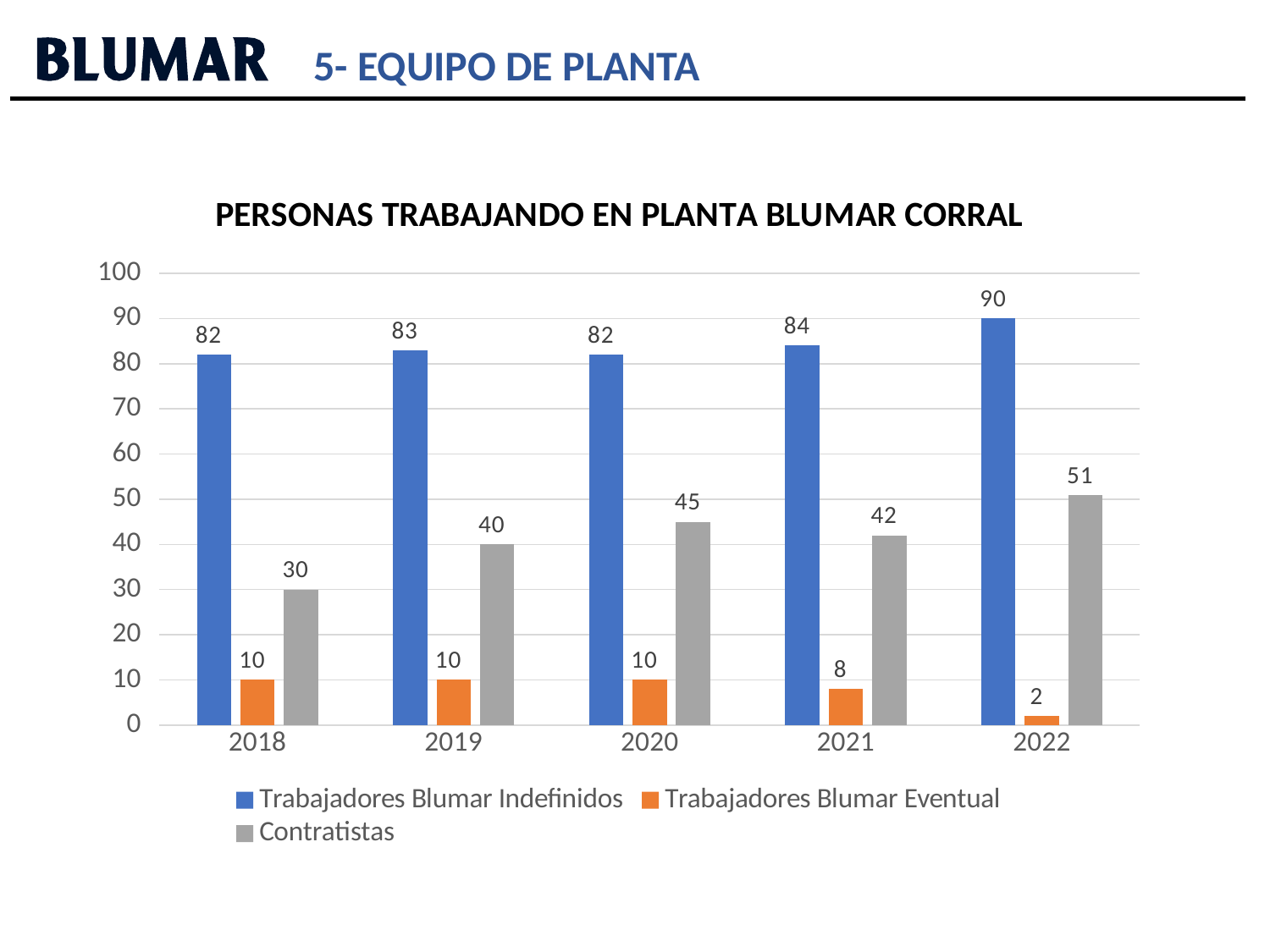
How many series does the legend list? 3 Does the Contratistas series rise or fall from 2018 to 2022? Rise Which is larger, the Contratistas value in 2020 or in 2021? 2020 How many years are shown on the x axis? 5 What is the value for Trabajadores Blumar Indefinidos in 2022? 90 What is the value for Contratistas in 2018? 30 In which year is the Trabajadores Blumar Eventual value lowest? 2022 What is the value for Trabajadores Blumar Eventual in 2021? 8 What kind of chart is shown on the slide? Bar chart What is the difference between the Contratistas values for 2022 and 2018? 21 In which year is the Contratistas value highest? 2022 What is the title of the chart? PERSONAS TRABAJANDO EN PLANTA BLUMAR CORRAL